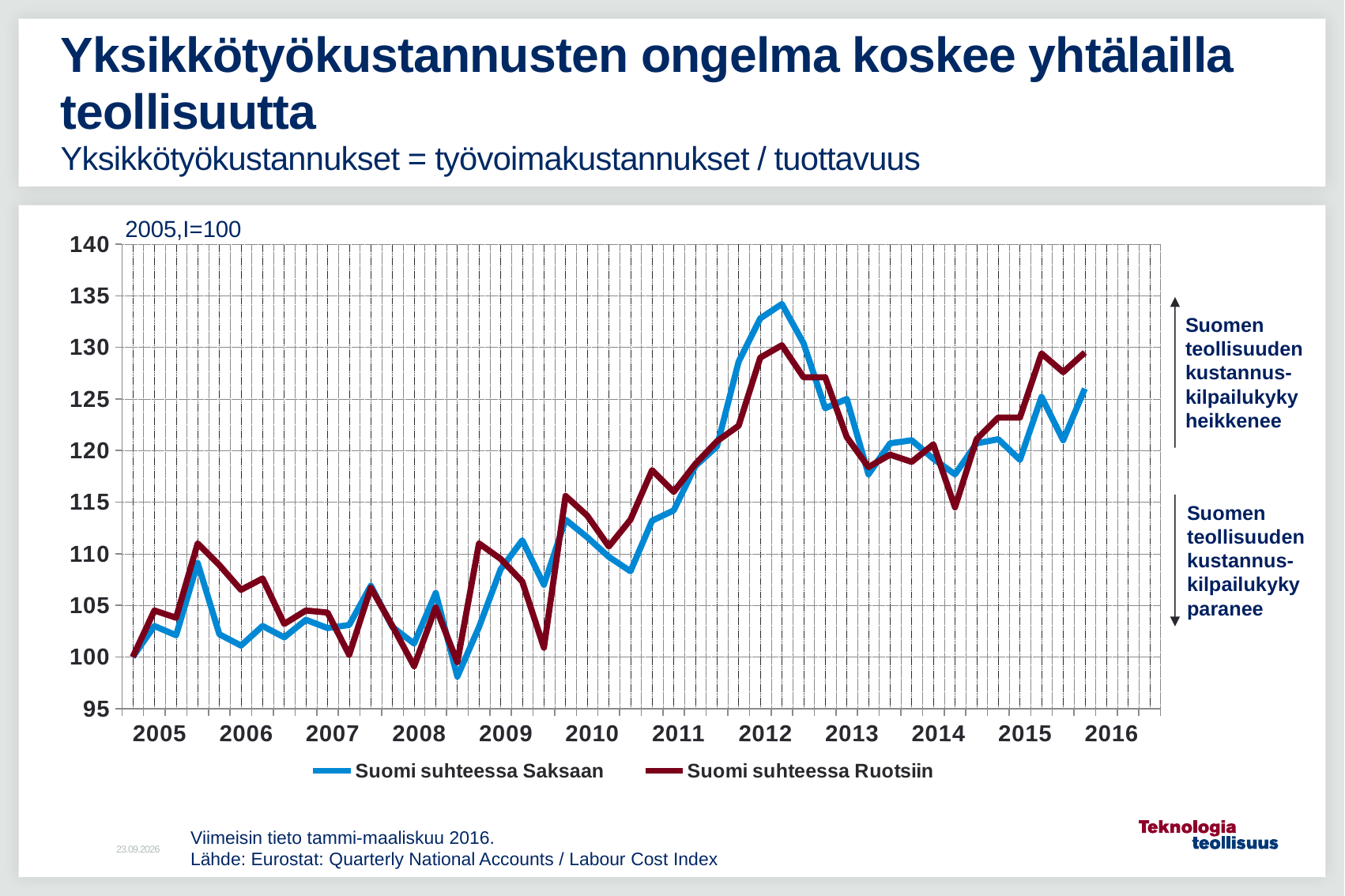
How many series does the legend list? 2 Is the value of the Suomi suhteessa Ruotsiin line at the start of 2015 greater or less than 120? greater At the last plotted point (early 2016), which series is higher: Suomi suhteessa Saksaan or Suomi suhteessa Ruotsiin? Suomi suhteessa Ruotsiin In which year does the Suomi suhteessa Saksaan line reach its highest value? 2012 Between 2008 and 2012, do the values of the Suomi suhteessa Saksaan line generally rise or fall? rise What are the two series named in the legend? Suomi suhteessa Saksaan; Suomi suhteessa Ruotsiin What base index is stated above the chart? 2005,I=100 At the 2012 peak, which series is higher: Suomi suhteessa Saksaan or Suomi suhteessa Ruotsiin? Suomi suhteessa Saksaan Is the peak value of the Suomi suhteessa Saksaan line in 2012 greater or less than 130? greater How many year labels are shown on the x axis? 12 Is the lowest value of the Suomi suhteessa Saksaan line in 2008 greater or less than 100? less What kind of chart is shown on the slide? line chart